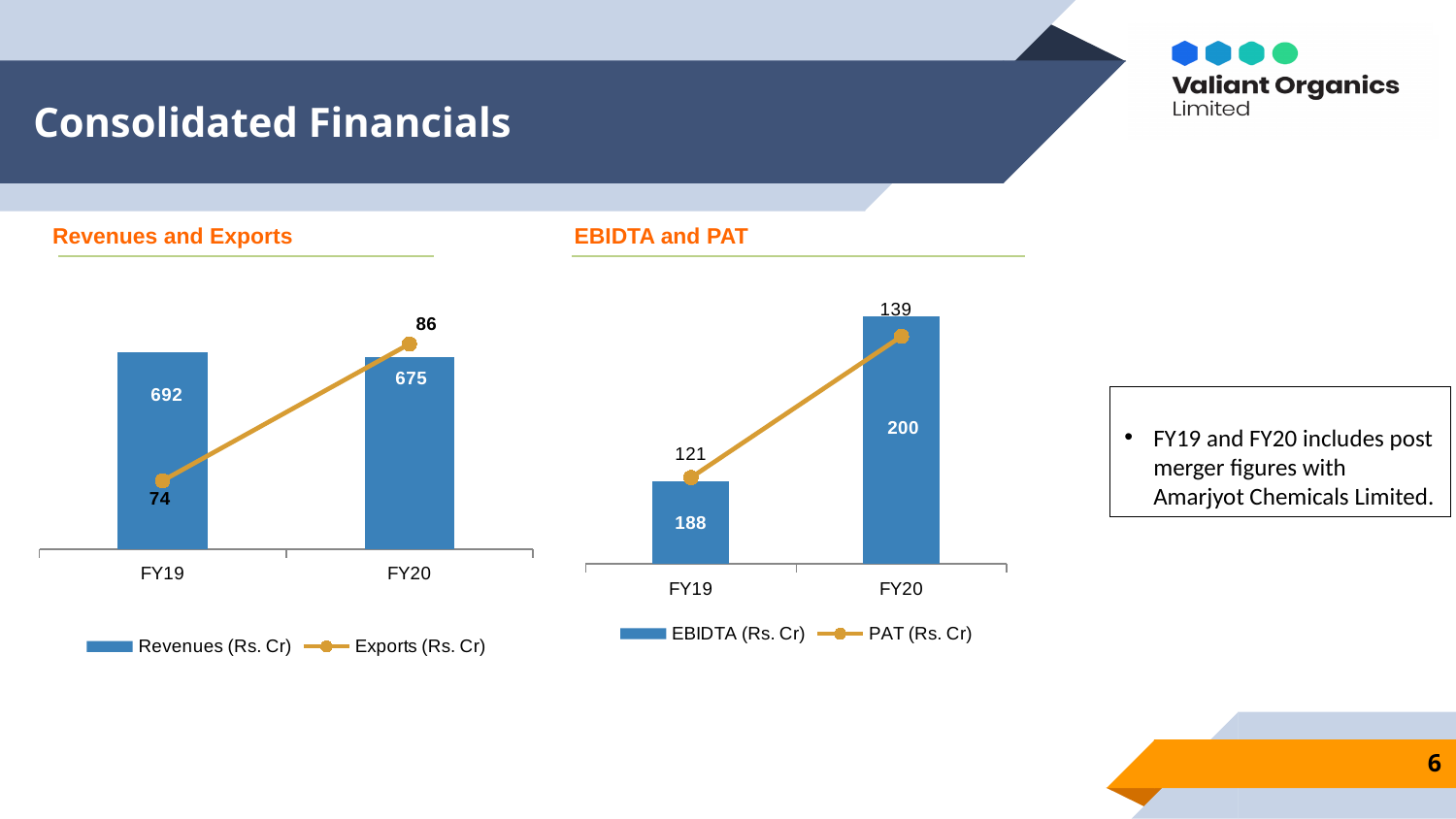
In the EBIDTA and PAT chart, what is the EBIDTA value for FY20? 200 In the Revenues and Exports chart, which year has the higher Revenues value? FY19 In the EBIDTA and PAT chart, do PAT values rise or fall from FY19 to FY20? rise How many categories are shown on the x axis of the Revenues and Exports chart? 2 In the Revenues and Exports chart, what is the Exports value for FY20? 86 In the Revenues and Exports chart, by how much did Exports change from FY19 to FY20? 12 In the Revenues and Exports chart, do Revenues rise or fall from FY19 to FY20? fall How many series does the legend of the EBIDTA and PAT chart list? 2 In the Revenues and Exports chart, which series is plotted as a line with markers? Exports (Rs. Cr) In the EBIDTA and PAT chart, what is the difference between EBIDTA in FY20 and FY19? 12 In the EBIDTA and PAT chart, what is the PAT value for FY19? 121 In the Revenues and Exports chart, what is the Revenues value for FY19? 692